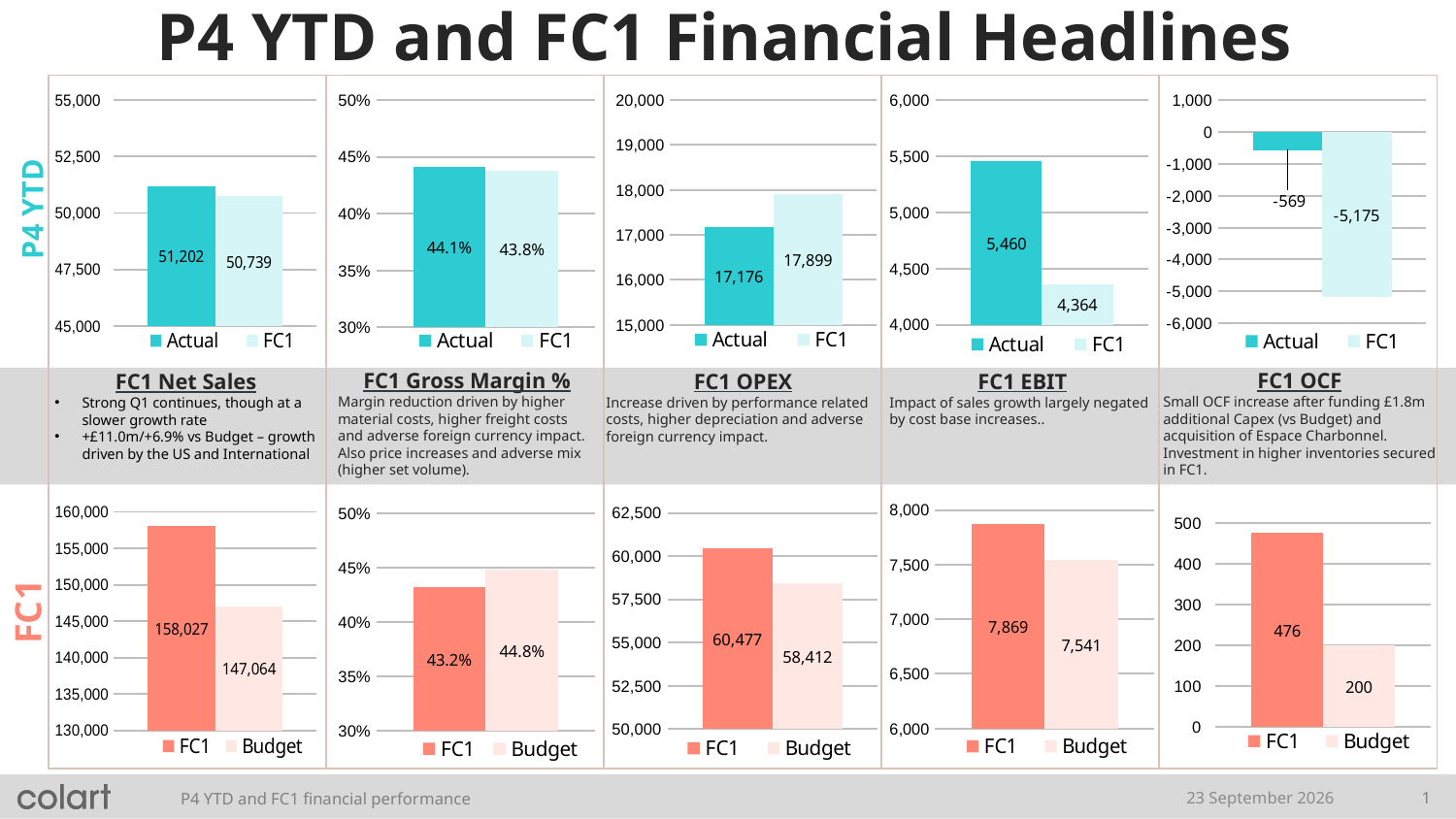
In the third chart of the bottom FC1 row (OPEX), what is the difference between the FC1 and Budget values? 2,065 In the third chart of the top P4 YTD row (OPEX), which bar is larger, Actual or FC1? FC1 In the fifth chart of the top P4 YTD row (OCF), what is the value of the FC1 bar? -5,175 In the first chart of the top P4 YTD row (net sales), what is the value of the FC1 bar? 50,739 In the first chart of the bottom FC1 row (net sales), what is the value of the Budget bar? 147,064 In the second chart of the bottom FC1 row (gross margin %), which bar is larger, FC1 or Budget? Budget In the fifth chart of the bottom FC1 row (OCF), how many series does the legend list? 2 In the first chart of the top P4 YTD row (net sales), what is the value of the Actual bar? 51,202 In the fourth chart of the bottom FC1 row (EBIT), what is the value of the FC1 bar? 7,869 In the fourth chart of the top P4 YTD row (EBIT), what is the difference between the Actual and FC1 values? 1,096 What kind of chart is the fifth chart of the bottom FC1 row (OCF)? Bar chart In the second chart of the top P4 YTD row (gross margin %), what is the difference between the Actual and FC1 values? 0.3%